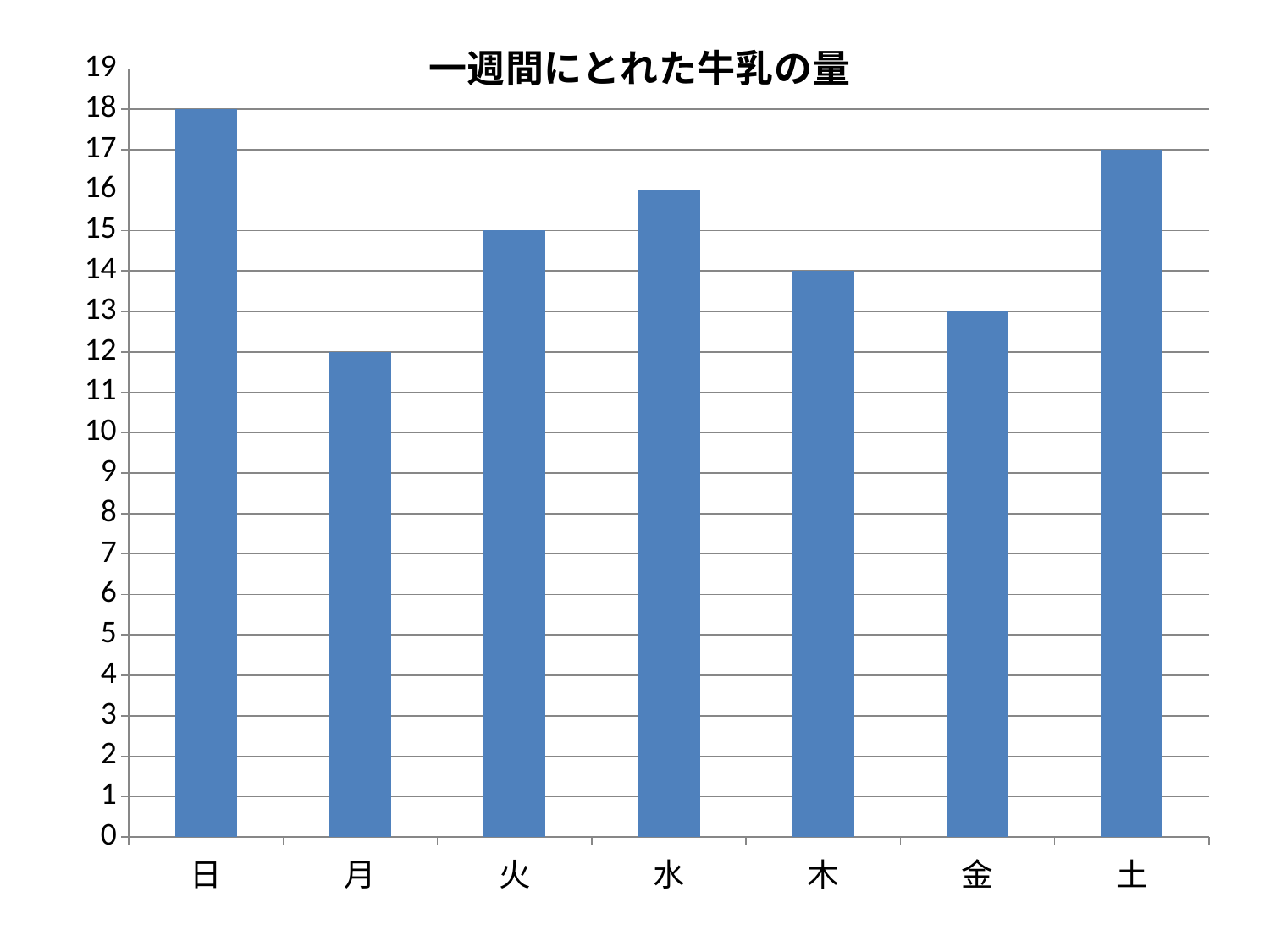
What is the value for 金? 13 What is the value for 日? 18 What is the difference between the values for 日 and 月? 6 What is the value for 月? 12 What is the value for 水? 16 What is the title of the chart? 一週間にとれた牛乳の量 Is the value for 土 greater or less than 15? greater Which day has the highest value? 日 Which day has the lowest value? 月 Which is larger, the value for 火 or the value for 木? 火 What kind of chart is this? bar chart How many days are shown on the x axis? 7